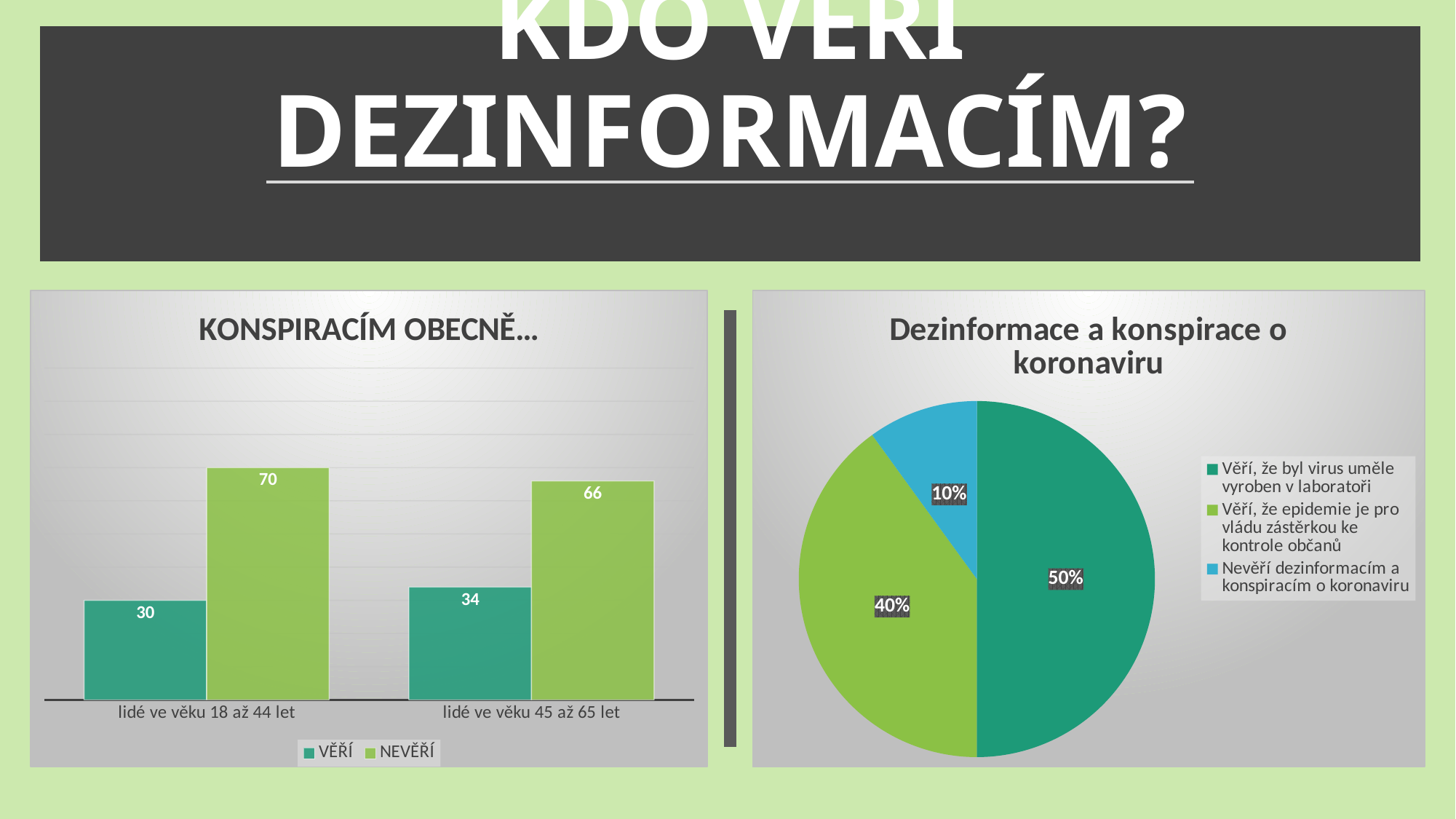
In the pie chart titled "Dezinformace a konspirace o koronaviru", which slice is the smallest? Nevěří dezinformacím a konspiracím o koronaviru How many slices does the pie chart titled "Dezinformace a konspirace o koronaviru" have? 3 In the bar chart titled "KONSPIRACÍM OBECNĚ...", what is the value for NEVĚŘÍ among lidé ve věku 45 až 65 let? 66 In the bar chart titled "KONSPIRACÍM OBECNĚ...", what is the difference between the NEVĚŘÍ and VĚŘÍ values for lidé ve věku 18 až 44 let? 40 What kind of chart is the chart on the right of the slide? pie chart In the pie chart titled "Dezinformace a konspirace o koronaviru", what share is labelled for "Věří, že byl virus uměle vyroben v laboratoři"? 50% How many series does the legend of the bar chart titled "KONSPIRACÍM OBECNĚ..." list? 2 What kind of chart is the chart on the left of the slide? bar chart In the bar chart titled "KONSPIRACÍM OBECNĚ...", what is the value for VĚŘÍ among lidé ve věku 18 až 44 let? 30 In the bar chart titled "KONSPIRACÍM OBECNĚ...", which category has the highest NEVĚŘÍ value? lidé ve věku 18 až 44 let In the bar chart titled "KONSPIRACÍM OBECNĚ...", which is larger: VĚŘÍ for lidé ve věku 18 až 44 let or VĚŘÍ for lidé ve věku 45 až 65 let? lidé ve věku 45 až 65 let In the pie chart titled "Dezinformace a konspirace o koronaviru", what share is labelled for "Nevěří dezinformacím a konspiracím o koronaviru"? 10%